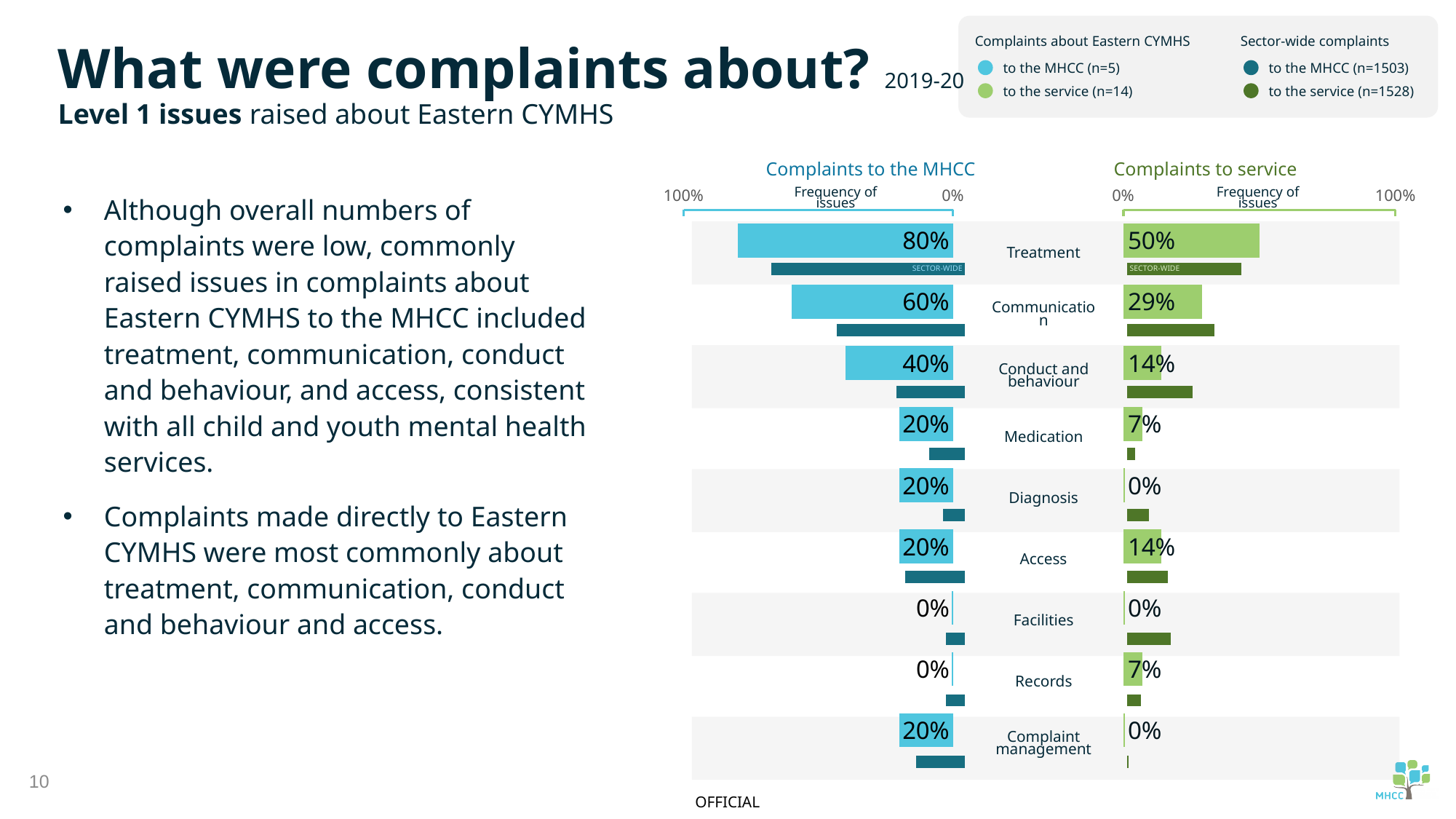
In the 'Complaints to the MHCC' chart, which issue has the highest frequency for Eastern CYMHS? Treatment In the 'Complaints to service' chart, is the Eastern CYMHS value for Treatment greater or less than the value for Records? greater In the 'Complaints to the MHCC' chart, what is the difference between the Eastern CYMHS values for Treatment and Communication? 20% What type of chart is used to show the frequency of issues? Bar chart In the 'Complaints to service' chart, what percentage of complaints about Eastern CYMHS raised Communication? 29% How many issue categories are listed in the charts? 9 In the 'Complaints to the MHCC' chart, what percentage of complaints about Eastern CYMHS raised Treatment? 80% In the 'Complaints to service' chart, what is the difference between the Eastern CYMHS values for Treatment and Conduct and behaviour? 36% According to the legend, how many complaints about Eastern CYMHS were made to the service? 14 In the 'Complaints to service' chart, what is the Eastern CYMHS value for Medication? 7% Which is larger for Eastern CYMHS: the Access value in the 'Complaints to the MHCC' chart or the Access value in the 'Complaints to service' chart? Complaints to the MHCC In the 'Complaints to the MHCC' chart, what is the Eastern CYMHS value for Facilities? 0%